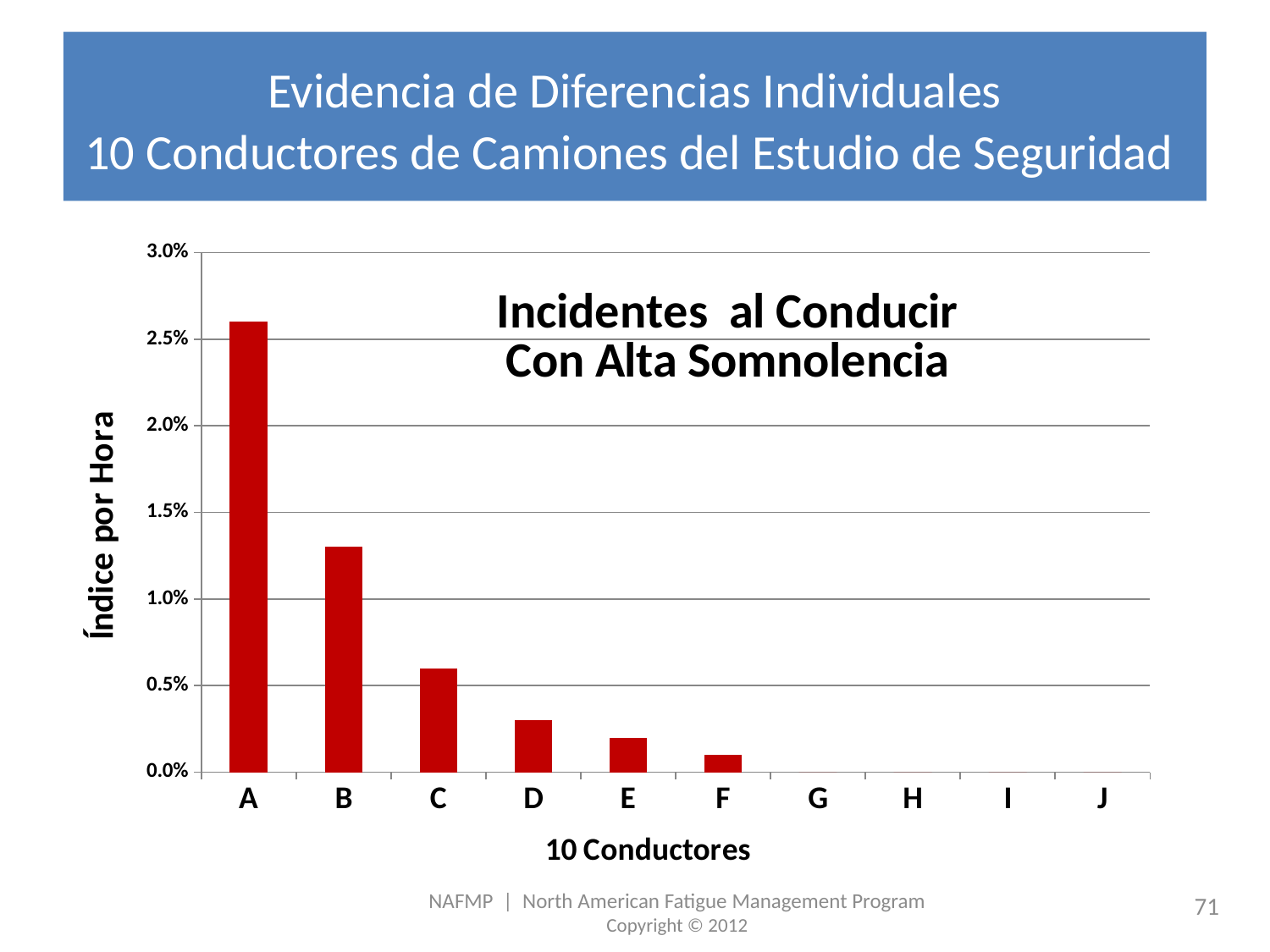
How many drivers (categories) are shown on the x axis of the chart? 10 What is the title of the chart's vertical axis? Índice por Hora Is the value for driver B greater or less than 1.0%? greater What kind of chart is shown on the slide? bar chart Which driver has the highest incident rate in the chart? A What is the title printed inside the chart area? Incidentes al Conducir Con Alta Somnolencia Is the value for driver A greater or less than 2.5%? greater Is the value for driver C greater or less than 0.5%? greater Which driver has the larger value, A or B? A Which driver has the larger value, C or D? C Do the values rise or fall moving from driver A to driver J along the x axis? fall